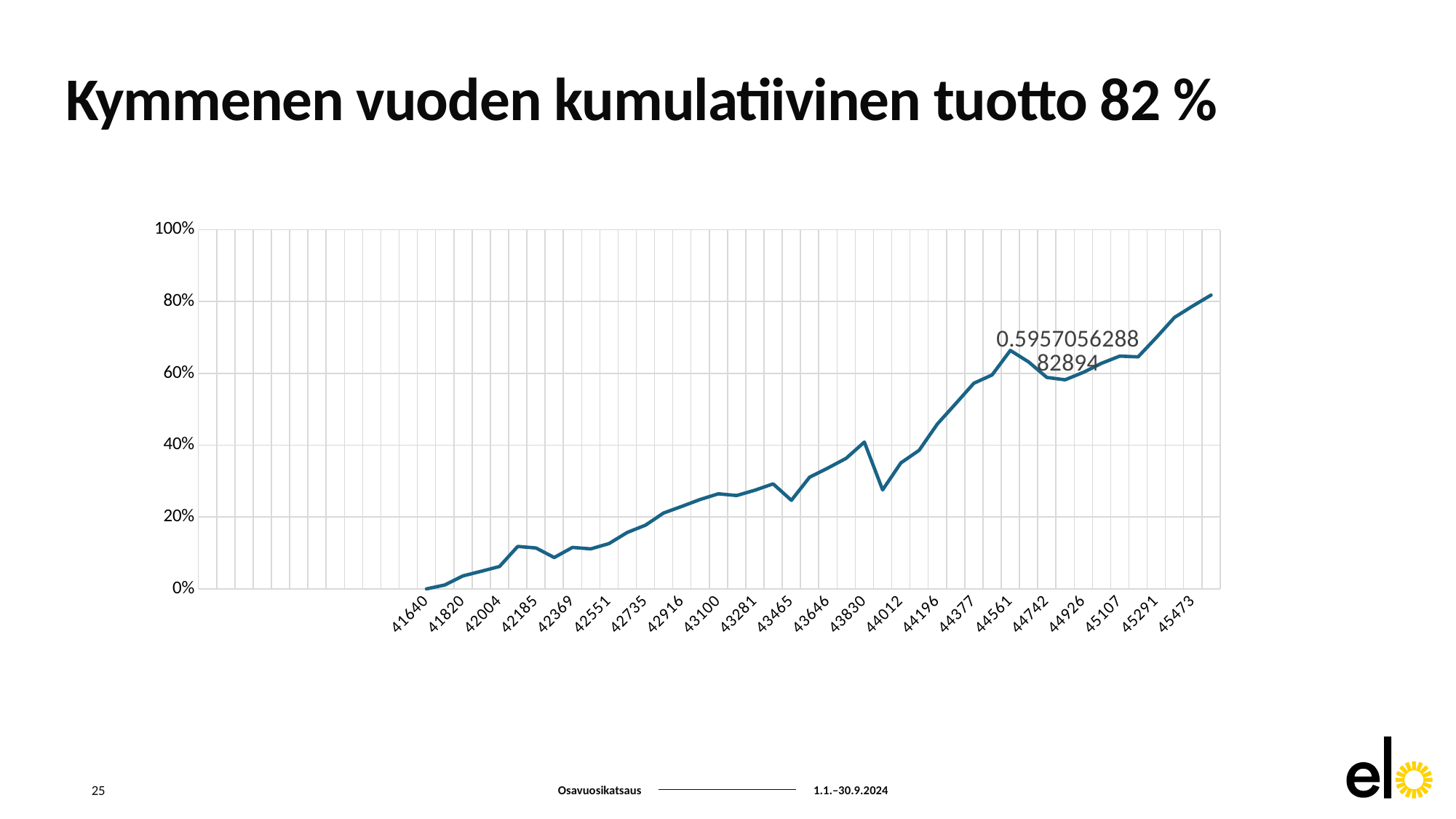
What data label is printed on the line near the 44742 mark? 0.595705628882894 Which has the larger value, 44561 or 44742? 44561 What kind of chart is shown on the slide? line chart Overall, do the values rise or fall from left to right along the x axis? rise Is the value at 42185 greater or less than 20%? less Which has the larger value, 43830 or 44012? 43830 What is the title of the slide containing the chart? Kymmenen vuoden kumulatiivinen tuotto 82 % Is the value at 44012 greater or less than 40%? less Is the value at 43465 greater or less than 40%? less How many labels are shown on the x axis? 22